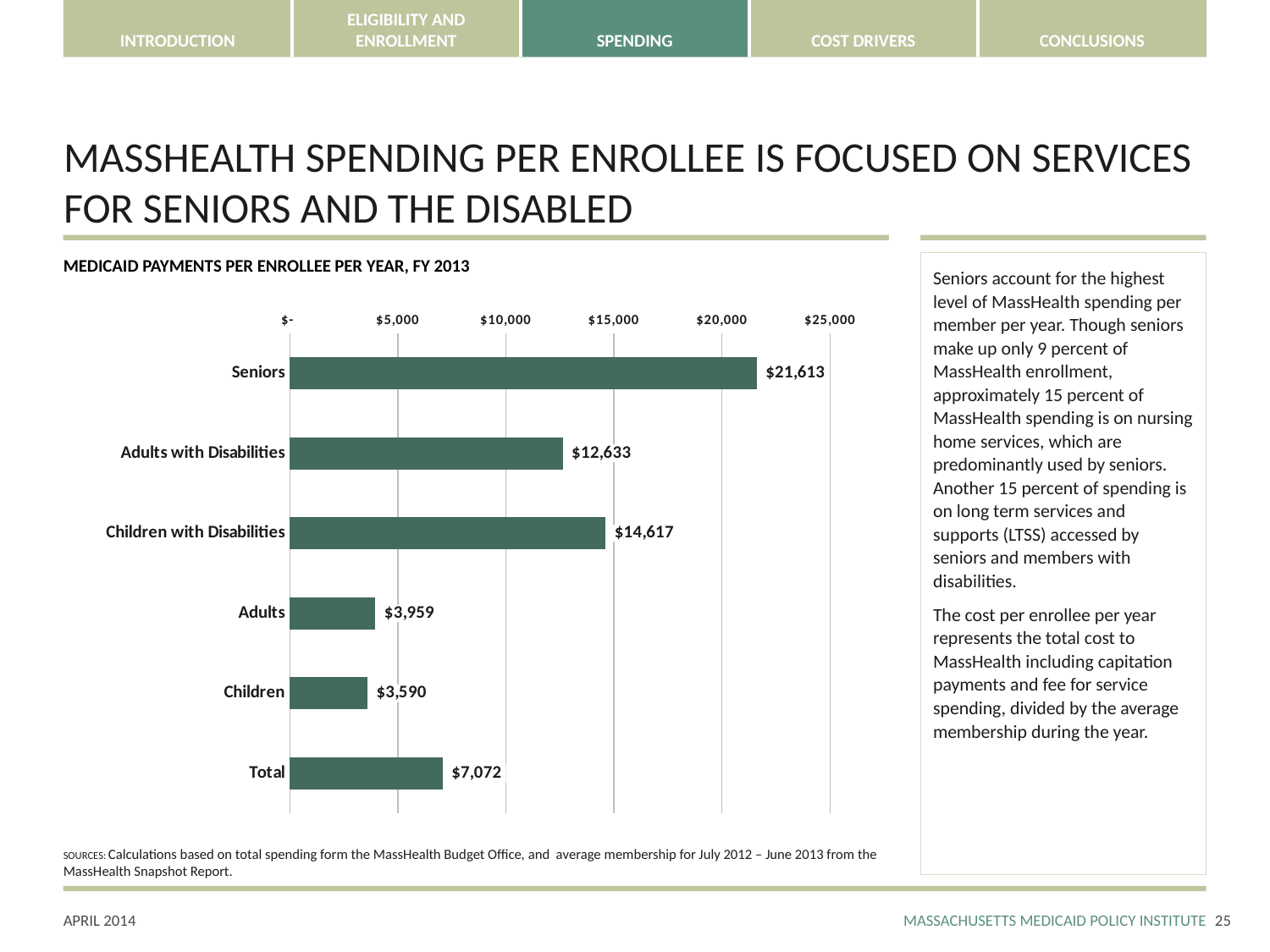
What kind of chart is used to show Medicaid payments per enrollee per year? Bar chart What is the Medicaid payment per enrollee per year for Children? $3,590 What is the Medicaid payment per enrollee per year for Adults with Disabilities? $12,633 Which category has the highest Medicaid payment per enrollee per year? Seniors Which has a higher payment per enrollee: Children with Disabilities or Adults with Disabilities? Children with Disabilities What is the Medicaid payment per enrollee per year for Seniors? $21,613 Which category has the lowest Medicaid payment per enrollee per year? Children What is the Total Medicaid payment per enrollee per year? $7,072 What is the difference between the payment per enrollee for Seniors and for Adults with Disabilities? $8,980 How many categories are shown in the chart? 6 Is the payment per enrollee for Seniors greater or less than $20,000? greater What is the difference between the payment per enrollee for Adults and for Children? $369